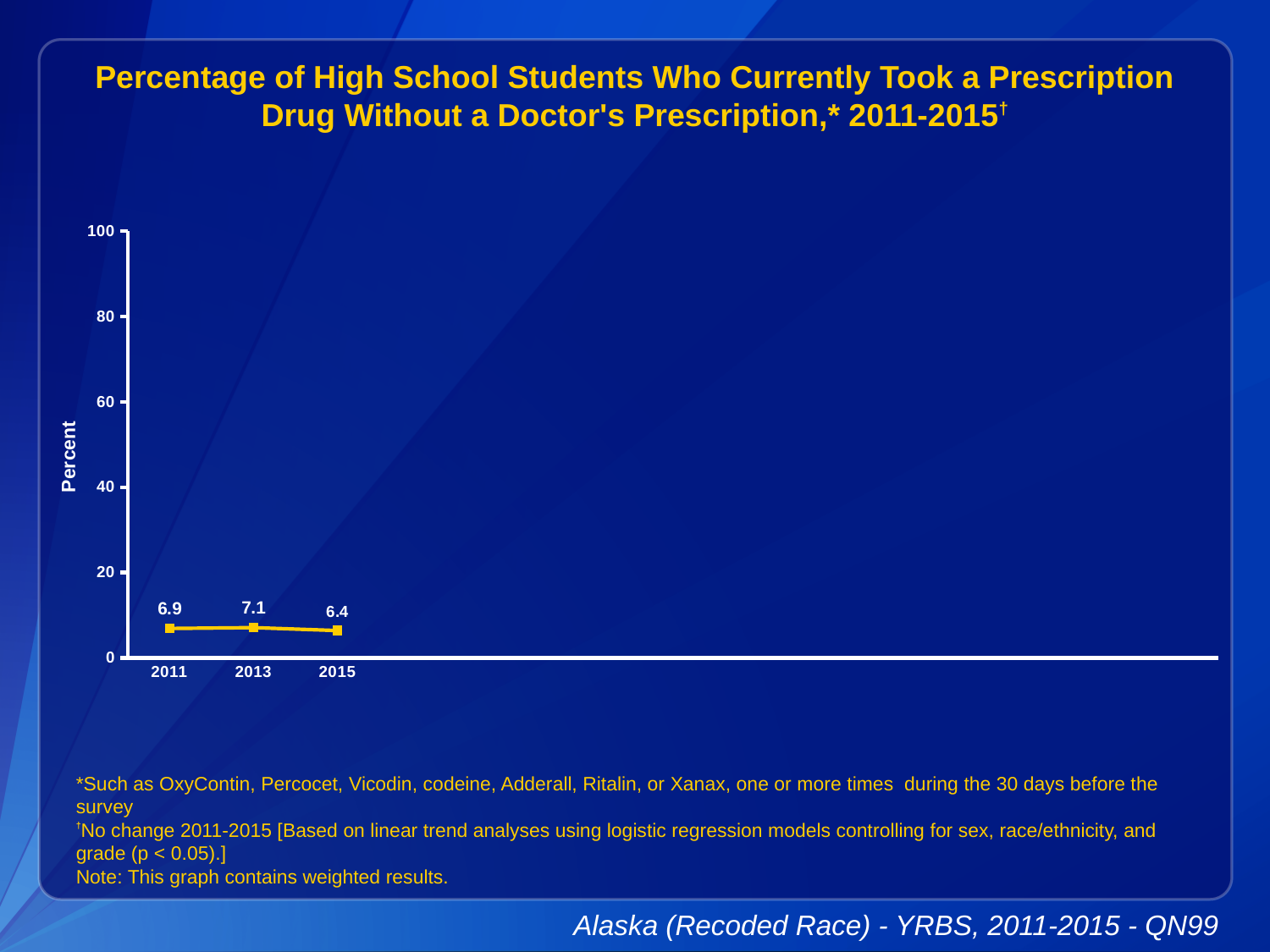
What is the value for 2013? 7.1 Which year has the lowest value? 2015 What is the difference between the values for 2013 and 2015? 0.7 What is the value for 2011? 6.9 Which is larger, the value for 2011 or the value for 2015? 2011 What kind of chart is shown on the slide? line chart What is the difference between the values for 2011 and 2015? 0.5 Which year has the highest value? 2013 What is the value for 2015? 6.4 What is the label on the y axis? Percent Is the value for 2013 greater or less than 20? less How many years are plotted on the chart? 3